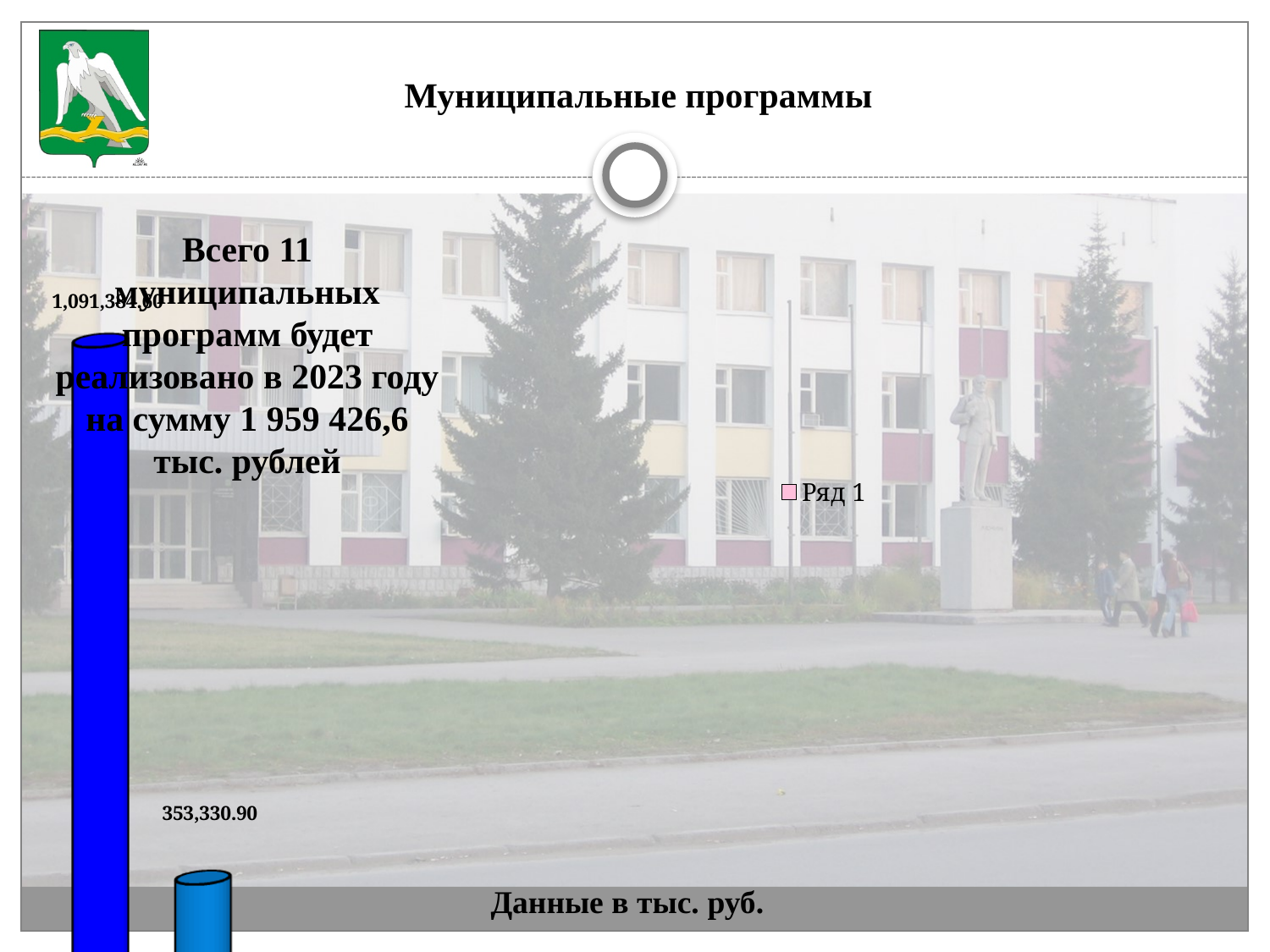
Which of the two visible bars is taller, the left one or the right one? the left one In what units are the chart's data given, according to the note at the bottom of the slide? тыс. руб. What is the data label on the shorter (right) bar of the chart? 353,330.90 What kind of chart is shown on the slide? bar chart What is the name of the series shown in the chart legend? Ряд 1 How many series does the chart legend list? 1